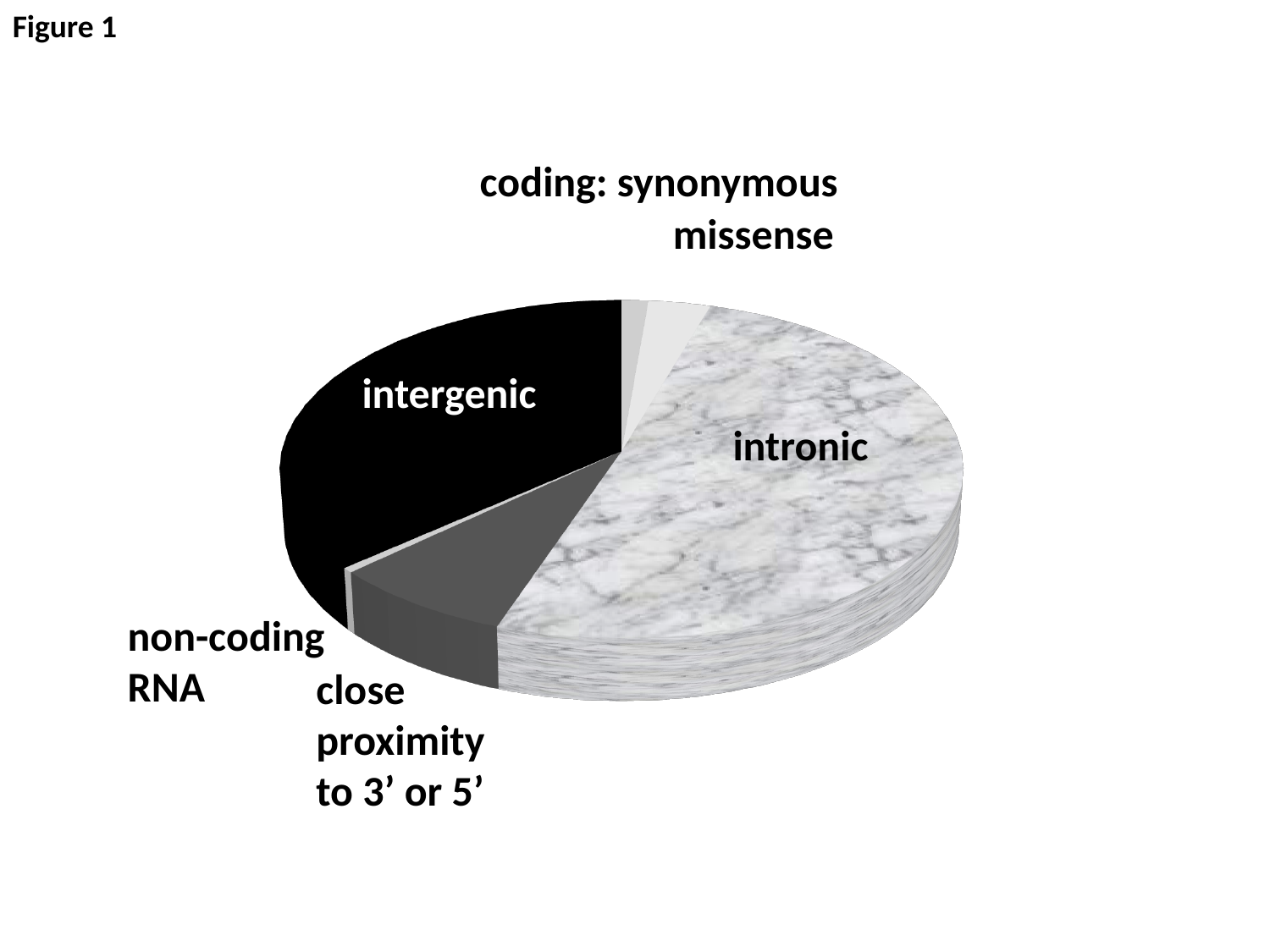
Which slice is larger, intronic or non-coding RNA? intronic What colour is the intergenic slice of the pie chart? black Which category has the largest slice of the pie chart? intronic What is the figure label shown at the top left of the slide? Figure 1 Which slice is larger, intronic or intergenic? intronic Which category has the second-largest slice of the pie chart? intergenic How many slices does the pie chart have? 6 Which slice is larger, intergenic or close proximity to 3' or 5'? intergenic What kind of chart is shown on the slide? pie chart